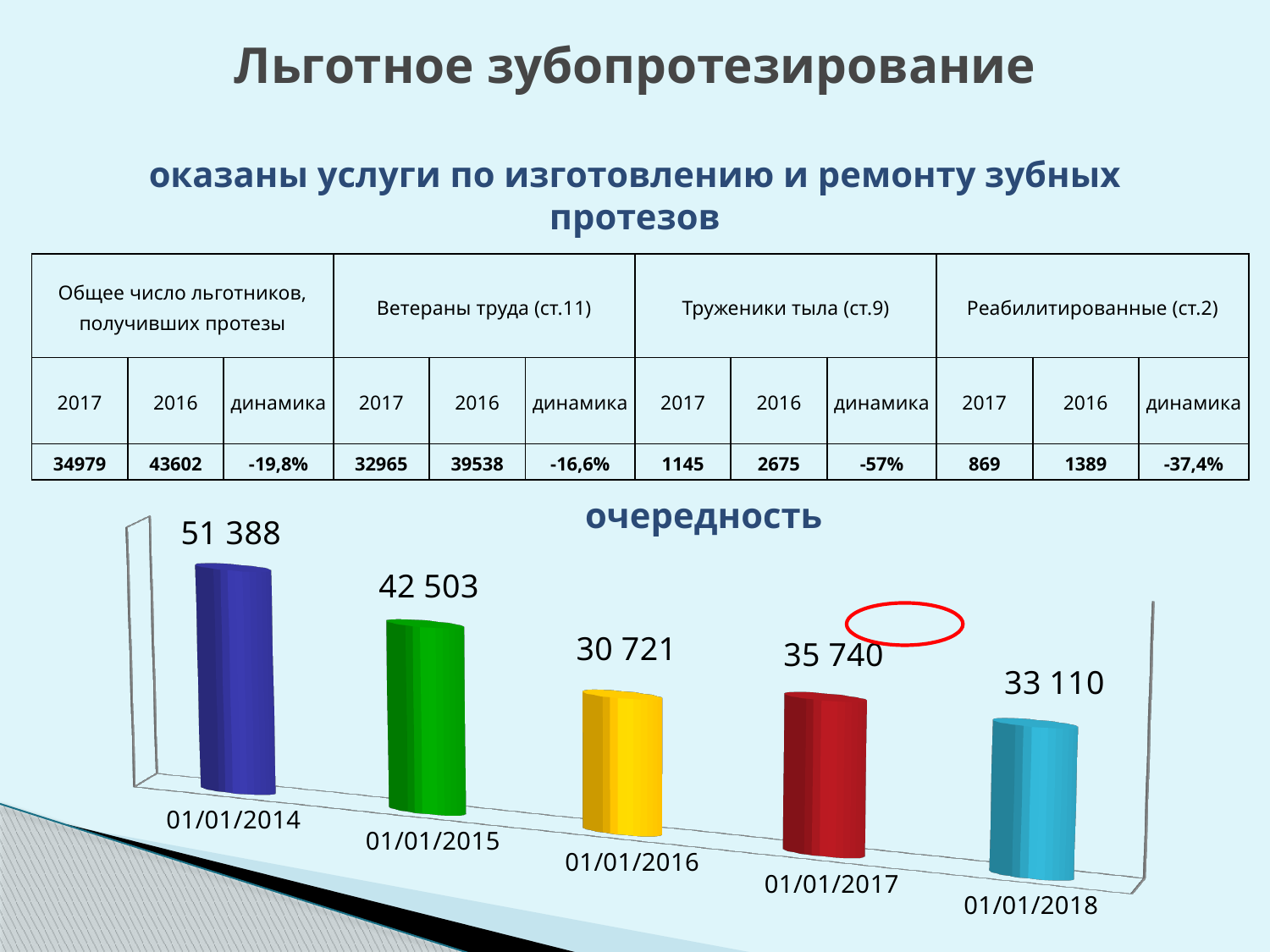
Which date has the lowest value in the "очередность" chart? 01/01/2016 What is the value for 01/01/2017 in the "очередность" chart? 35 740 In the "очередность" chart, do the values rise or fall from 01/01/2014 to 01/01/2016? fall What is the value for 01/01/2014 in the "очередность" chart? 51 388 What is the value for 01/01/2016 in the "очередность" chart? 30 721 Which date has the highest value in the "очередность" chart? 01/01/2014 What kind of chart is the "очередность" chart? bar chart What is the difference between the values for 01/01/2017 and 01/01/2018 in the "очередность" chart? 2 630 What is the value for 01/01/2018 in the "очередность" chart? 33 110 In the "очередность" chart, which is larger: the value for 01/01/2016 or 01/01/2017? 01/01/2017 How many dates are shown on the x axis of the "очередность" chart? 5 What is the difference between the values for 01/01/2014 and 01/01/2015 in the "очередность" chart? 8 885